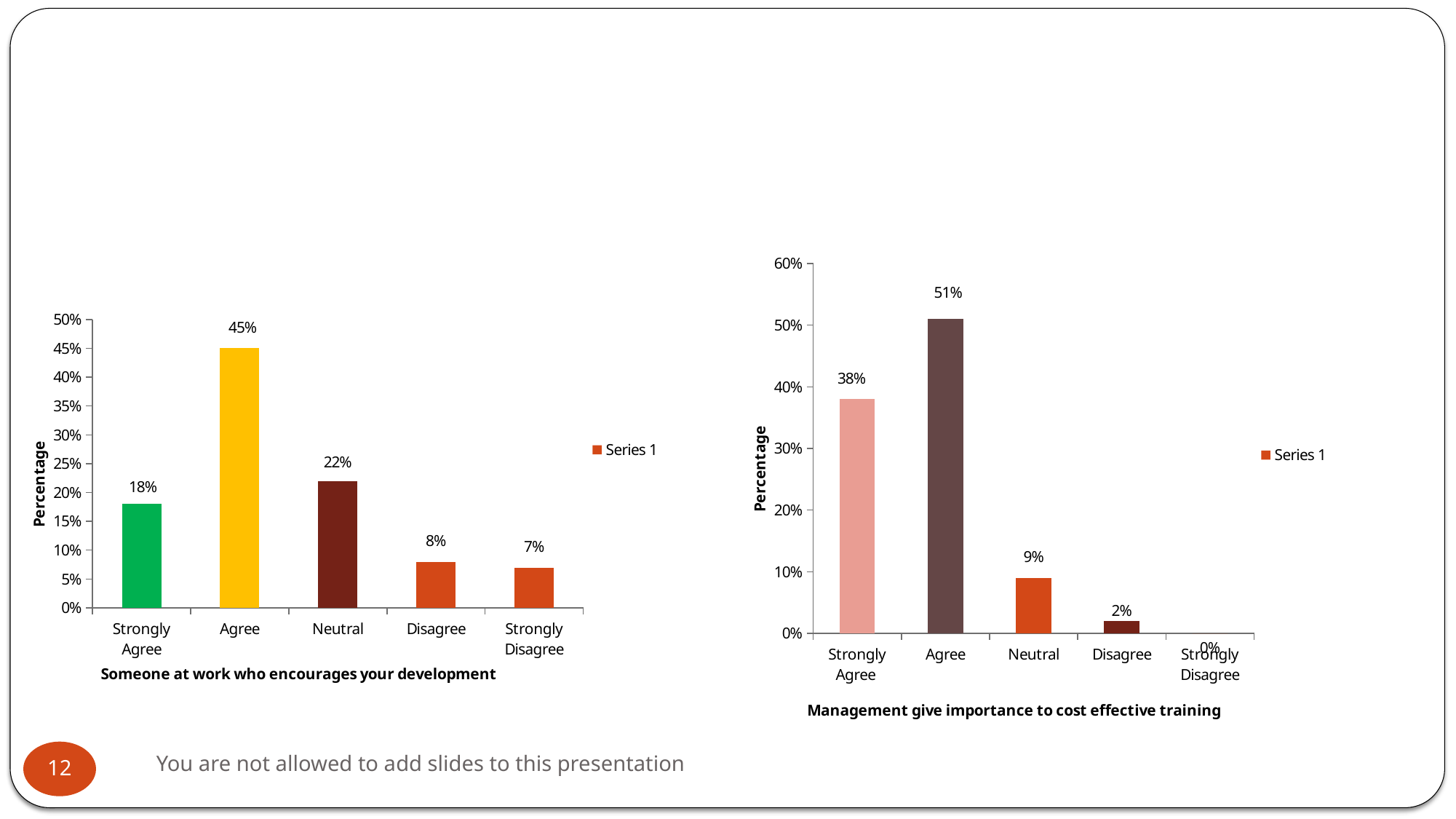
In the 'Management give importance to cost effective training' chart, which category has the highest value? Agree In the 'Management give importance to cost effective training' chart, what is the value for Strongly Disagree? 0% In the 'Someone at work who encourages your development' chart, what is the value for Agree? 45% In the 'Management give importance to cost effective training' chart, what is the difference between Agree and Neutral? 42% How many series does the legend of the 'Someone at work who encourages your development' chart list? 1 In the 'Management give importance to cost effective training' chart, which is larger, Neutral or Disagree? Neutral In the 'Someone at work who encourages your development' chart, what is the difference between Agree and Strongly Agree? 27% In the 'Someone at work who encourages your development' chart, which category has the lowest value? Strongly Disagree In the 'Someone at work who encourages your development' chart, what is the value for Neutral? 22% In the 'Management give importance to cost effective training' chart, what is the value for Strongly Agree? 38% What kind of chart is the 'Management give importance to cost effective training' chart? Bar chart In the 'Someone at work who encourages your development' chart, how many categories are shown on the x axis? 5